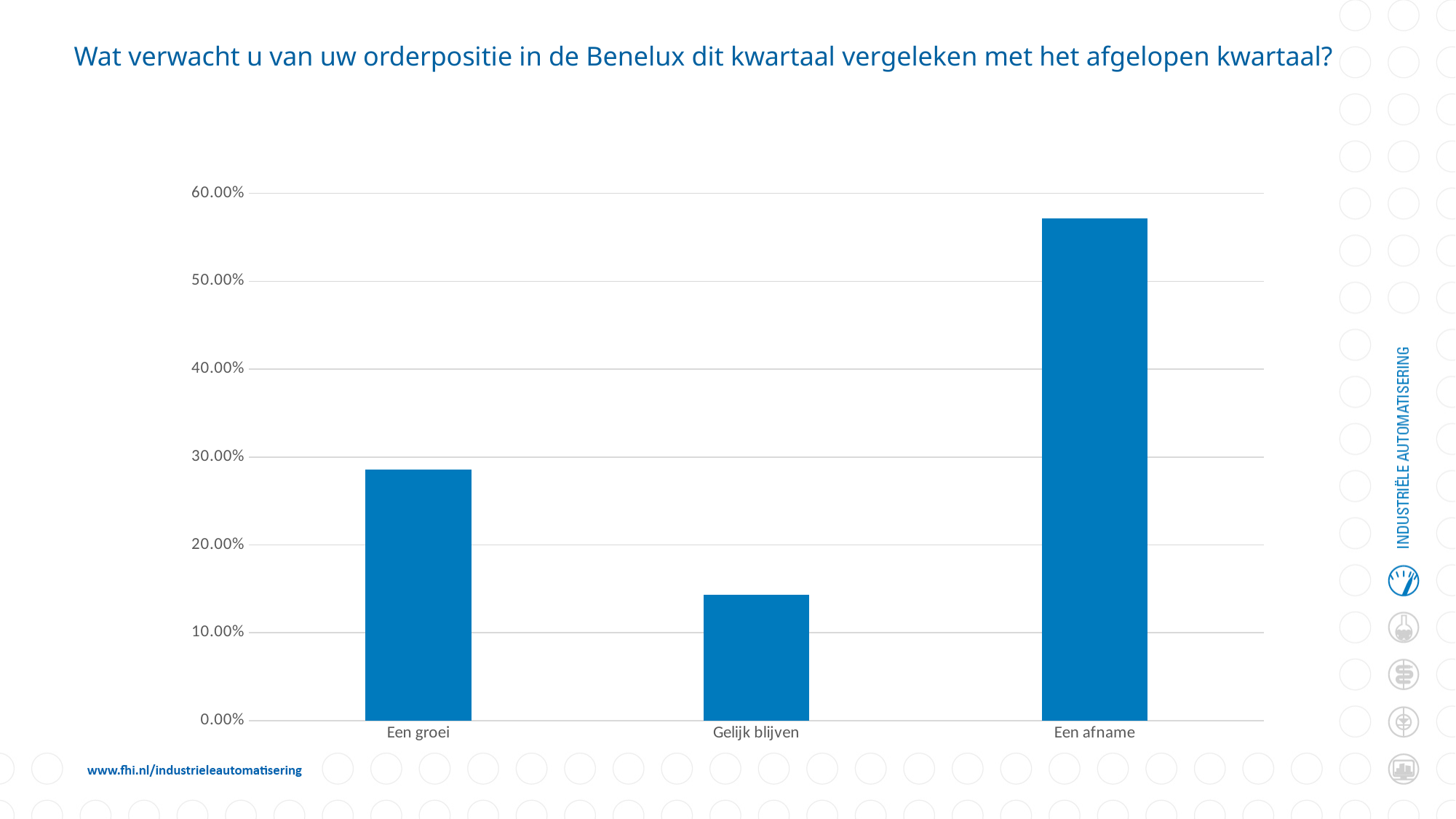
Is the value for Een groei greater or less than 30.00%? less Is the value for Gelijk blijven greater or less than 10.00%? greater Which category has the lowest value in the chart? Gelijk blijven How many categories are shown on the x axis of the chart? 3 Is the value for Een afname greater or less than 50.00%? greater What is the title of the chart on the slide? Wat verwacht u van uw orderpositie in de Benelux dit kwartaal vergeleken met het afgelopen kwartaal? What kind of chart is shown on the slide? bar chart Which is larger, the value for Een groei or the value for Gelijk blijven? Een groei Which category has the highest value in the chart? Een afname What is the highest value shown on the y axis of the chart? 60.00%